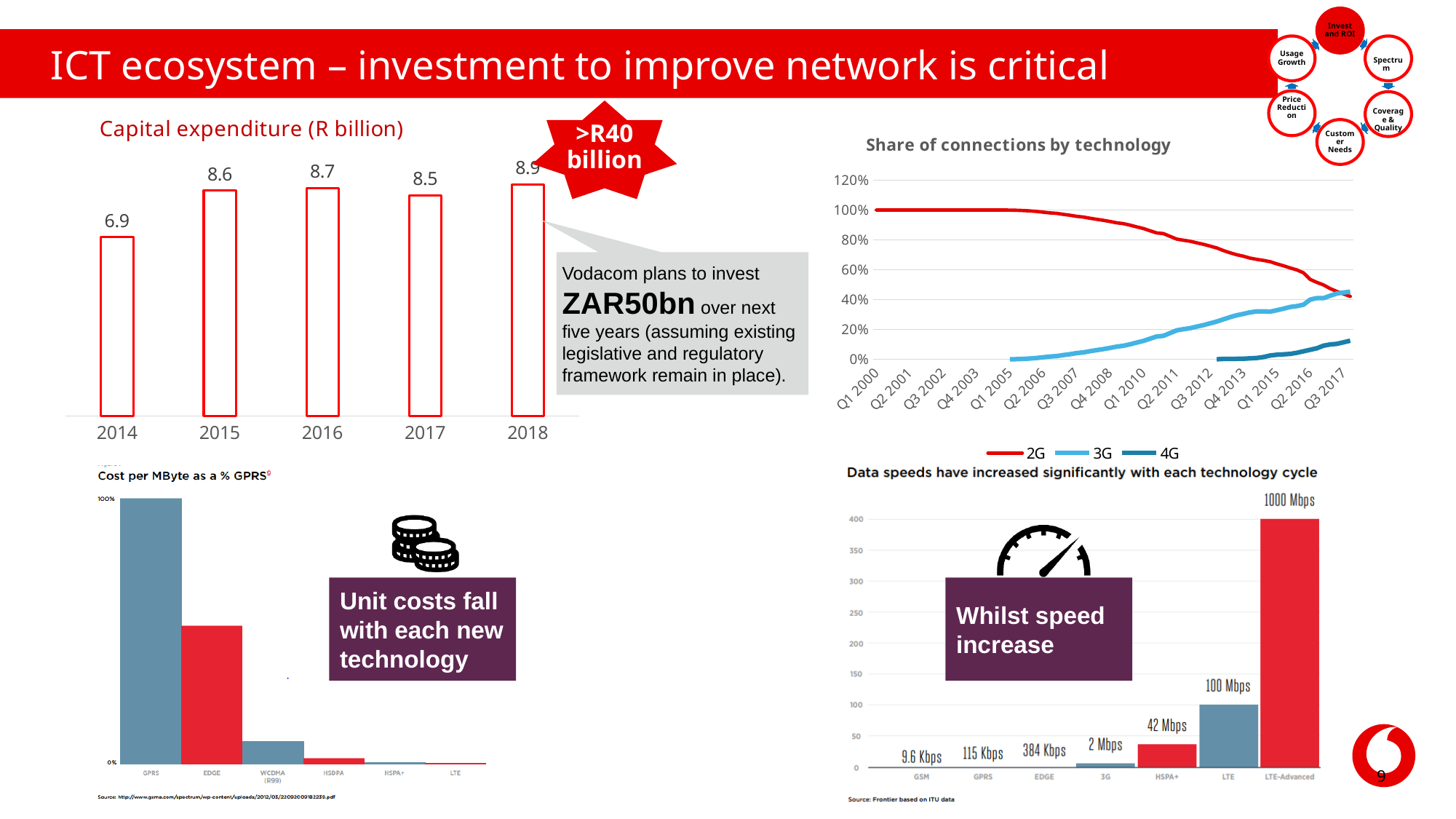
In the Capital expenditure (R billion) chart, which year has the highest value? 2018 In the Capital expenditure (R billion) chart, which year has the lowest value? 2014 In the Share of connections by technology chart, does the 2G share rise or fall over time? fall In the Cost per MByte as a % GPRS chart (bottom left), which technology has the highest cost? GPRS In the Capital expenditure (R billion) chart, what is the value for 2014? 6.9 In the Share of connections by technology chart, how many series does the legend list? 3 In the Capital expenditure (R billion) chart, what is the value for 2016? 8.7 In the Data speeds chart (bottom right), what is the data speed for LTE-Advanced? 1000 Mbps In the Capital expenditure (R billion) chart, what is the difference between the 2015 and 2014 values? 1.7 In the Capital expenditure (R billion) chart, how many years are shown? 5 In the Data speeds chart (bottom right), what is the data speed for HSPA+? 42 Mbps In the Share of connections by technology chart, is the 4G share at Q3 2017 greater or less than 20%? less